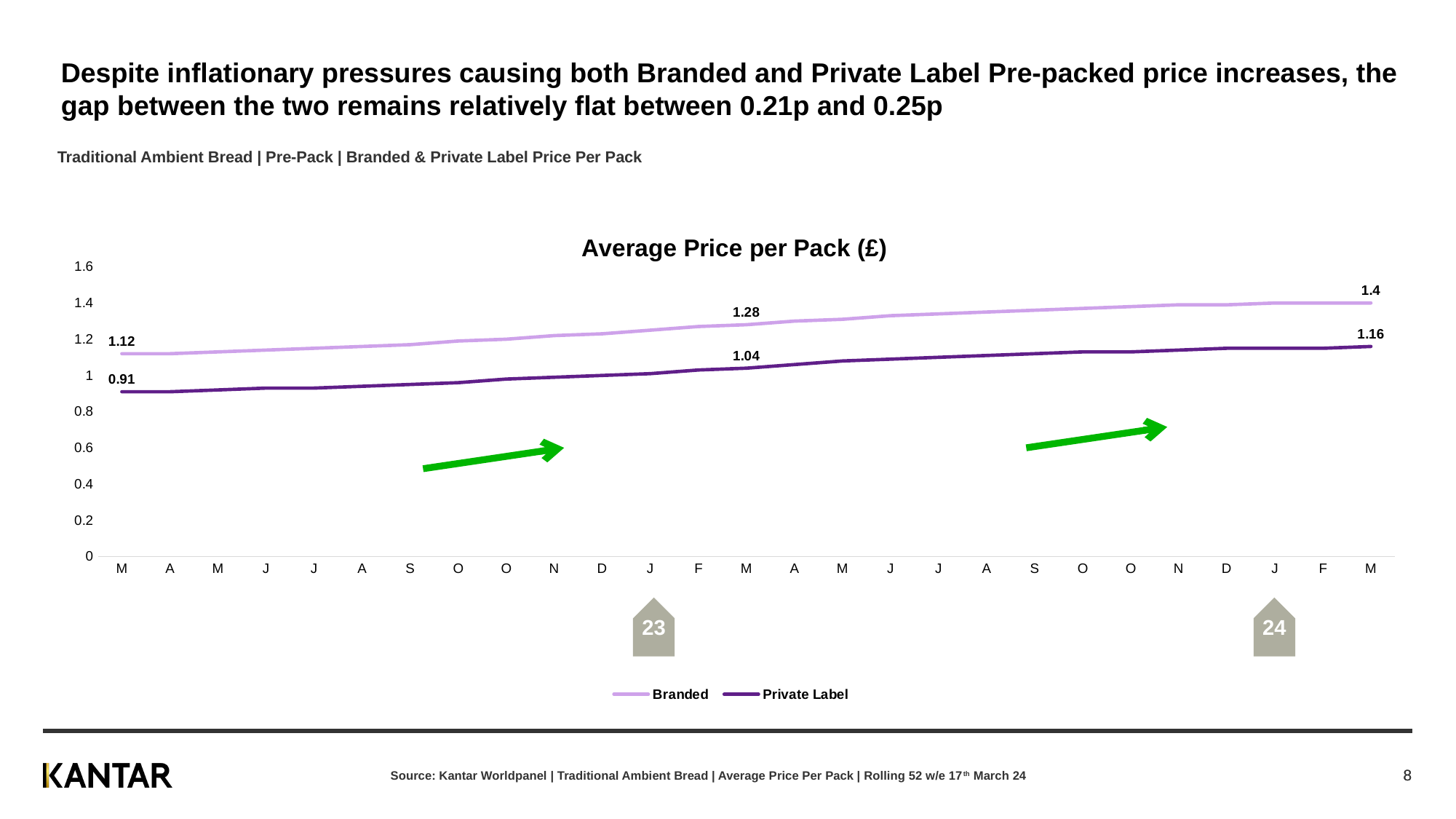
What is the Private Label average price per pack at the first point on the chart? 0.91 How many series does the legend list? 2 What is the title of the chart? Average Price per Pack (£) What is the Private Label average price per pack at the last point on the chart? 1.16 What is the Branded average price per pack at the first point on the chart? 1.12 Is the Private Label value at the first point greater or less than 1? less Do the Branded prices rise or fall along the x axis? rise What is the difference between the Branded and Private Label prices at the first point on the chart? 0.21 What is the Branded average price per pack at the last point on the chart? 1.4 Which series has the higher price at the point labelled 1.28 and 1.04, Branded or Private Label? Branded What is the difference between the Branded and Private Label prices at the last point on the chart? 0.24 What kind of chart is shown on the slide? line chart